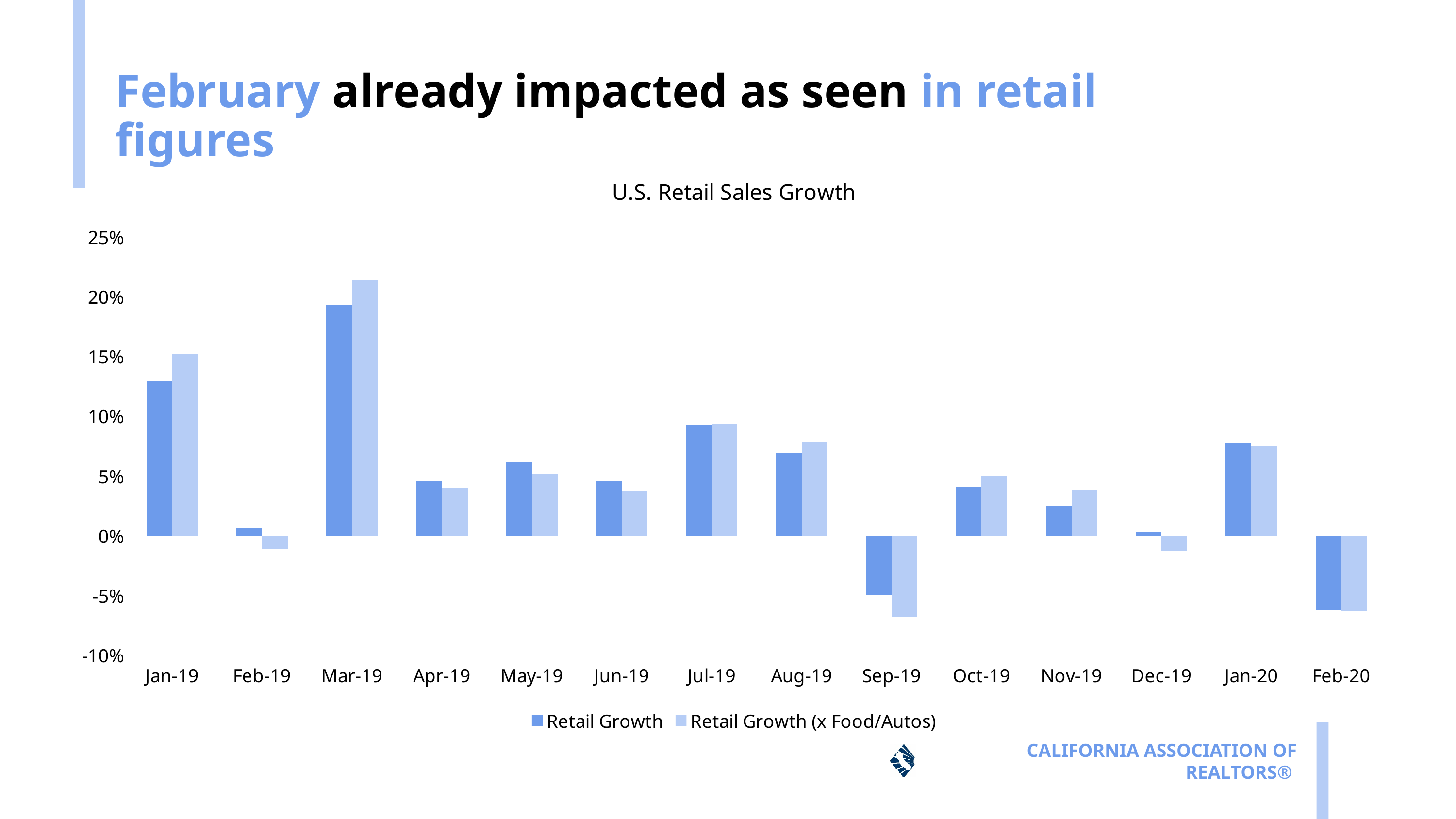
What is the title of the chart? U.S. Retail Sales Growth Which month has the lowest Retail Growth value? Feb-20 In Jan-19, which series has the larger value, Retail Growth or Retail Growth (x Food/Autos)? Retail Growth (x Food/Autos) Does the Retail Growth value rise or fall from Jul-19 to Sep-19? fall How many series does the legend list? 2 How many months are shown on the x axis? 14 Is the Retail Growth (x Food/Autos) value for Sep-19 greater or less than -5%? less Is the Retail Growth value for Jan-20 greater or less than 5%? greater Which month has the highest Retail Growth value? Mar-19 Is the Retail Growth (x Food/Autos) value for Mar-19 greater or less than 20%? greater What kind of chart is shown on the slide? bar chart